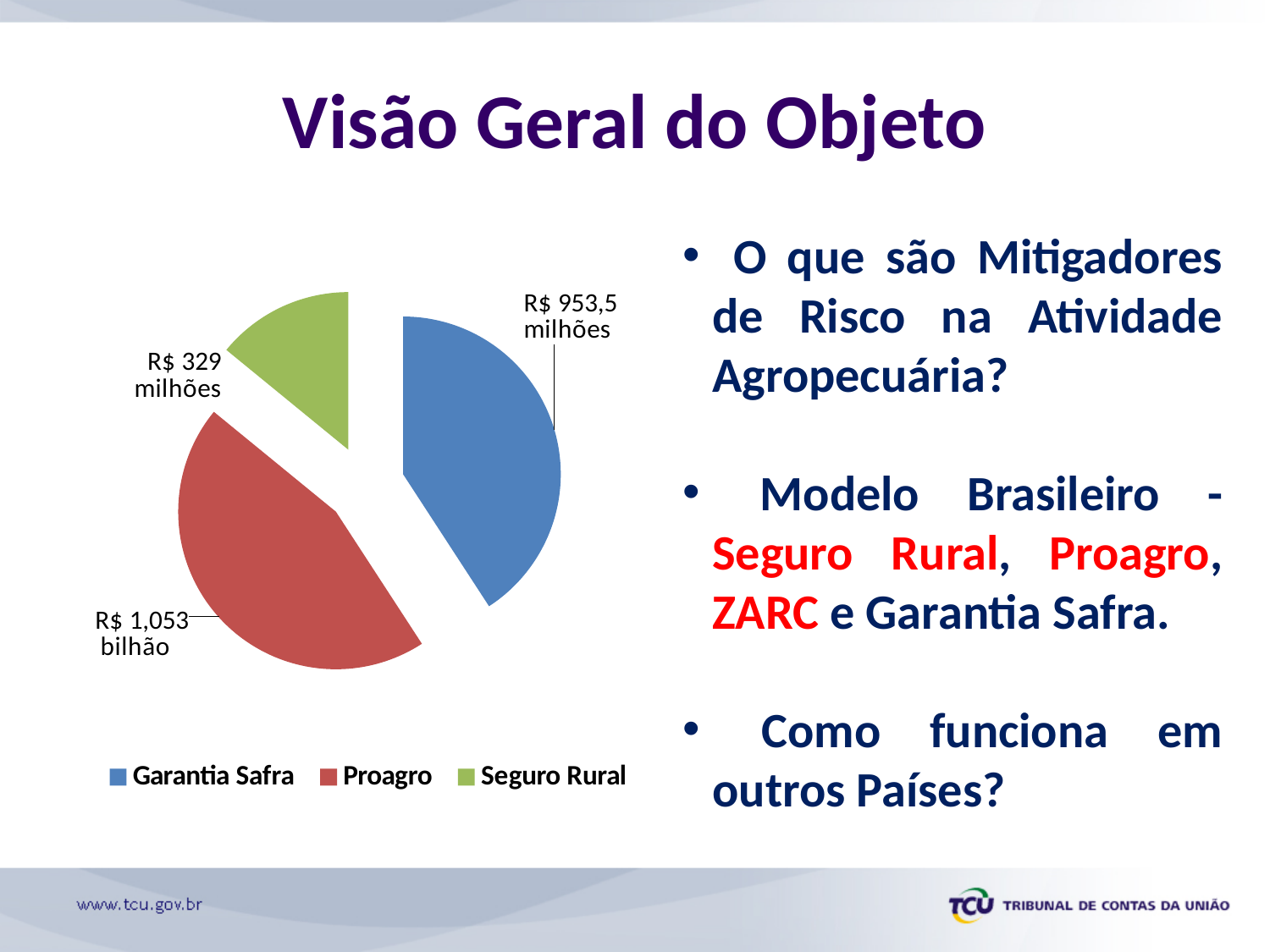
Which is larger in the pie chart, Proagro or Garantia Safra? Proagro Which category has the smallest slice in the pie chart? Seguro Rural What colour is the Proagro slice in the pie chart? Red Which category has the largest slice in the pie chart? Proagro What value is shown for the Garantia Safra slice of the pie chart? R$ 953,5 milhões What value is shown for the Seguro Rural slice of the pie chart? R$ 329 milhões What kind of chart is shown on the slide? Pie chart What value is shown for the Proagro slice of the pie chart? R$ 1,053 bilhão What is the difference between the Garantia Safra value and the Seguro Rural value in the pie chart? R$ 624,5 milhões How many entries does the legend of the pie chart list? 3 How many slices does the pie chart have? 3 Which is larger in the pie chart, Garantia Safra or Seguro Rural? Garantia Safra